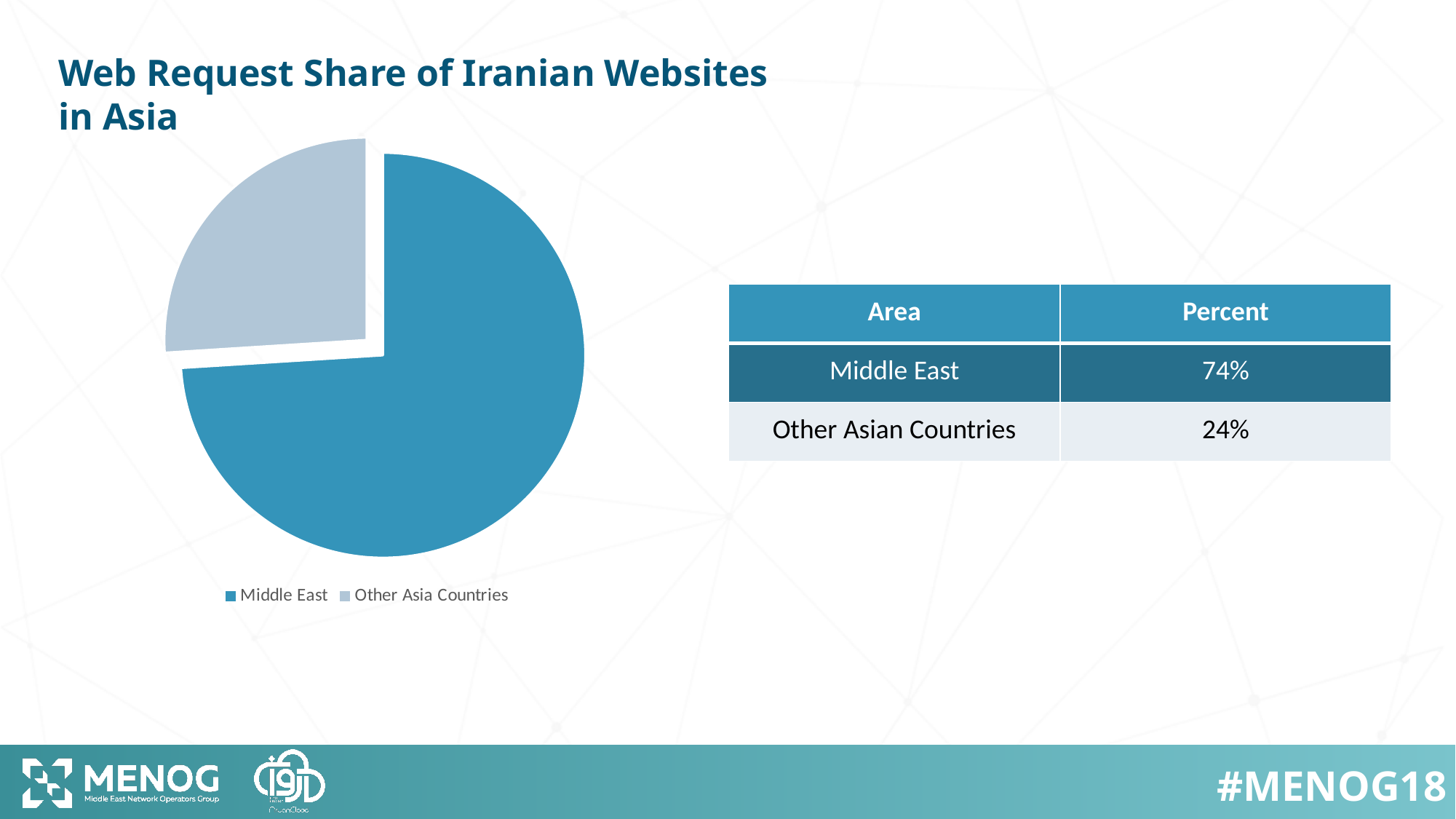
According to the table, what is the percent for Middle East? 74% What kind of chart is shown on the slide? pie chart Which legend entry is shown in the lighter grey-blue colour? Other Asia Countries Which area has the smallest share of the pie? Other Asia Countries What is the difference in percent between Middle East and Other Asian Countries? 50% According to the table, what is the percent for Other Asian Countries? 24% What is the title of the chart on the slide? Web Request Share of Iranian Websites in Asia How many entries does the legend of the pie chart list? 2 What are the two column headers of the table next to the pie chart? Area and Percent Which is larger, the share for Middle East or the share for Other Asian Countries? Middle East How many slices does the pie chart have? 2 Which area has the largest share of the pie? Middle East